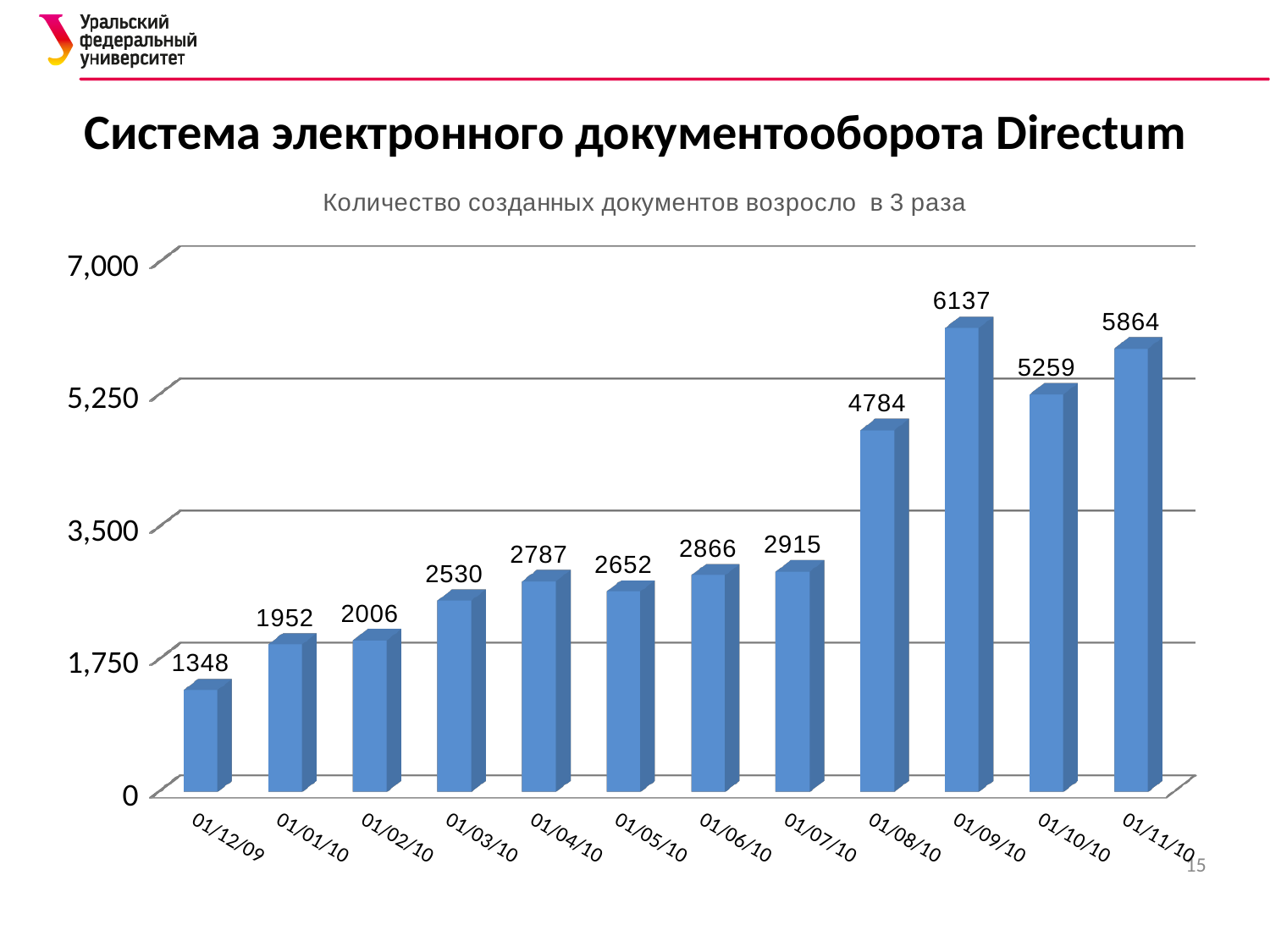
Which date has the highest value? 01/09/10 What is the value for 01/08/10? 4784 What is the value for 01/11/10? 5864 Is the value for 01/10/10 greater or less than 5,250? greater Which is larger, the value for 01/04/10 or the value for 01/05/10? 01/04/10 What is the difference between the values for 01/09/10 and 01/10/10? 878 How many dates are shown on the x axis? 12 Which date has the lowest value? 01/12/09 What is the difference between the values for 01/08/10 and 01/07/10? 1869 What kind of chart is shown on the slide? bar chart What is the value for 01/12/09? 1348 What is the title of the chart? Количество созданных документов возросло в 3 раза